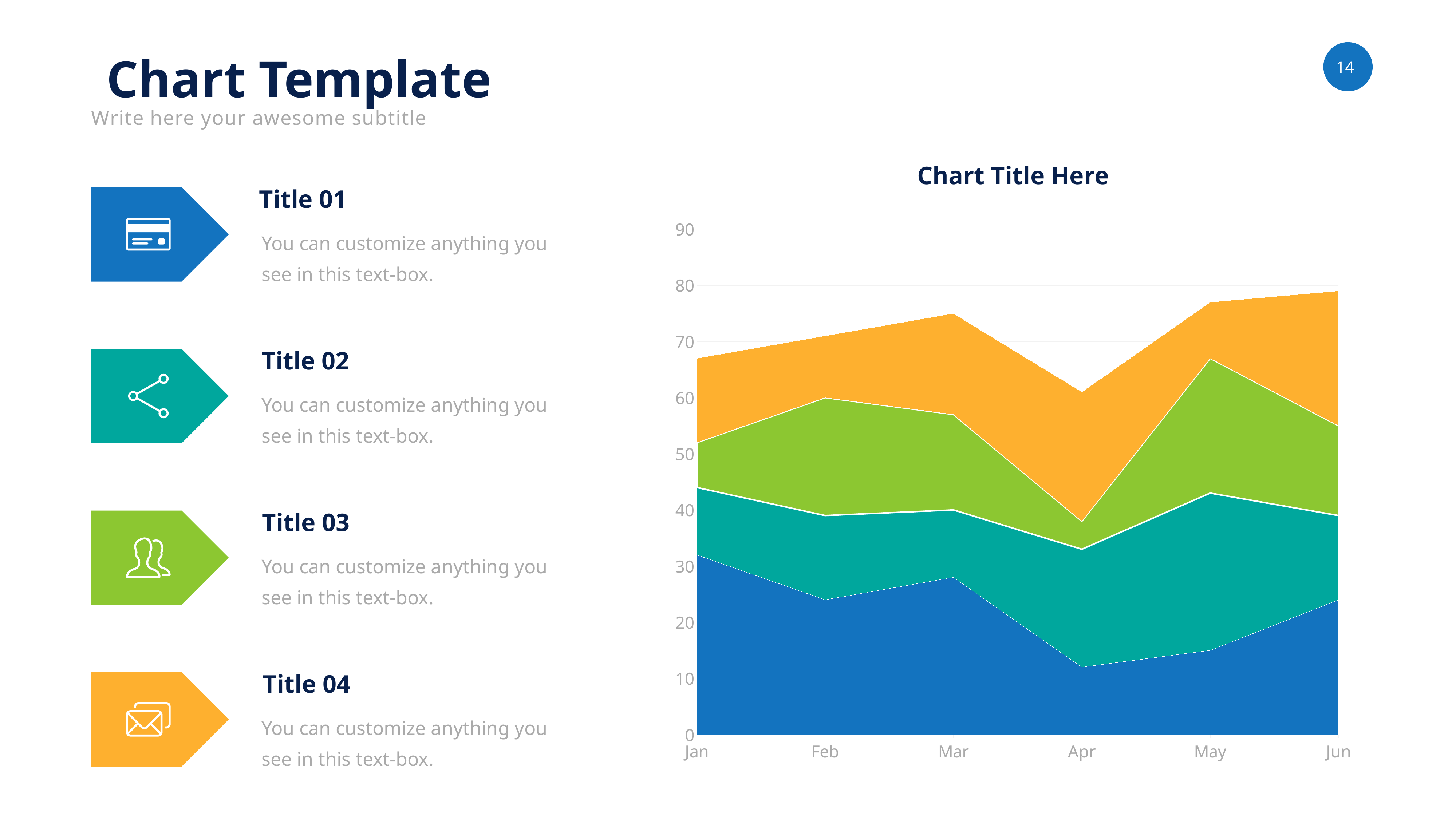
Is the top of the stacked areas in Jun greater or less than 70? greater In which month is the top of the stacked areas lowest? Apr Does the bottom (blue) series rise or fall from Jan to Apr? fall What colour is the bottom area series in the chart? blue How many months are shown on the x axis of the chart? 6 Is the value of the bottom (blue) series in Jan greater or less than 20? greater What is the title of the chart? Chart Title Here Is the value of the bottom (blue) series in Apr greater or less than 20? less What kind of chart is shown on the slide? stacked area chart Is the bottom (blue) series larger in Jan or in Apr? Jan In which month is the bottom (blue) series lowest? Apr